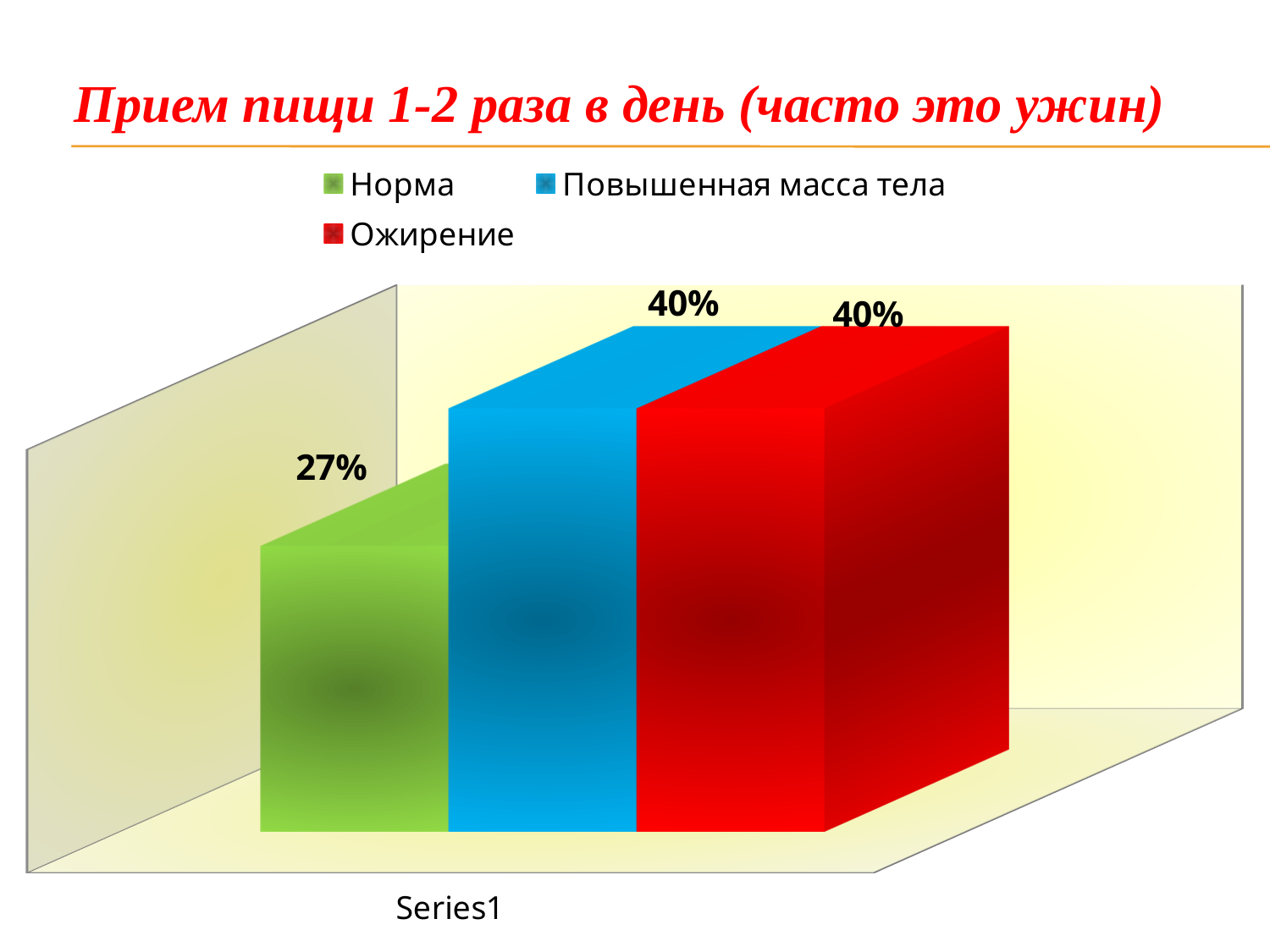
What is the difference between the values for Ожирение and Норма? 13% Which series has the lowest value? Норма How many series does the legend list? 3 What is the value for Норма? 27% What is the value for Ожирение? 40% Which series is shown in red? Ожирение What kind of chart is shown on the slide? Bar chart Which is larger, the value for Норма or the value for Ожирение? Ожирение What is the value for Повышенная масса тела? 40% What is the difference between the values for Повышенная масса тела and Норма? 13% What is the title of the slide? Прием пищи 1-2 раза в день (часто это ужин) Which is larger, the value for Повышенная масса тела or the value for Норма? Повышенная масса тела